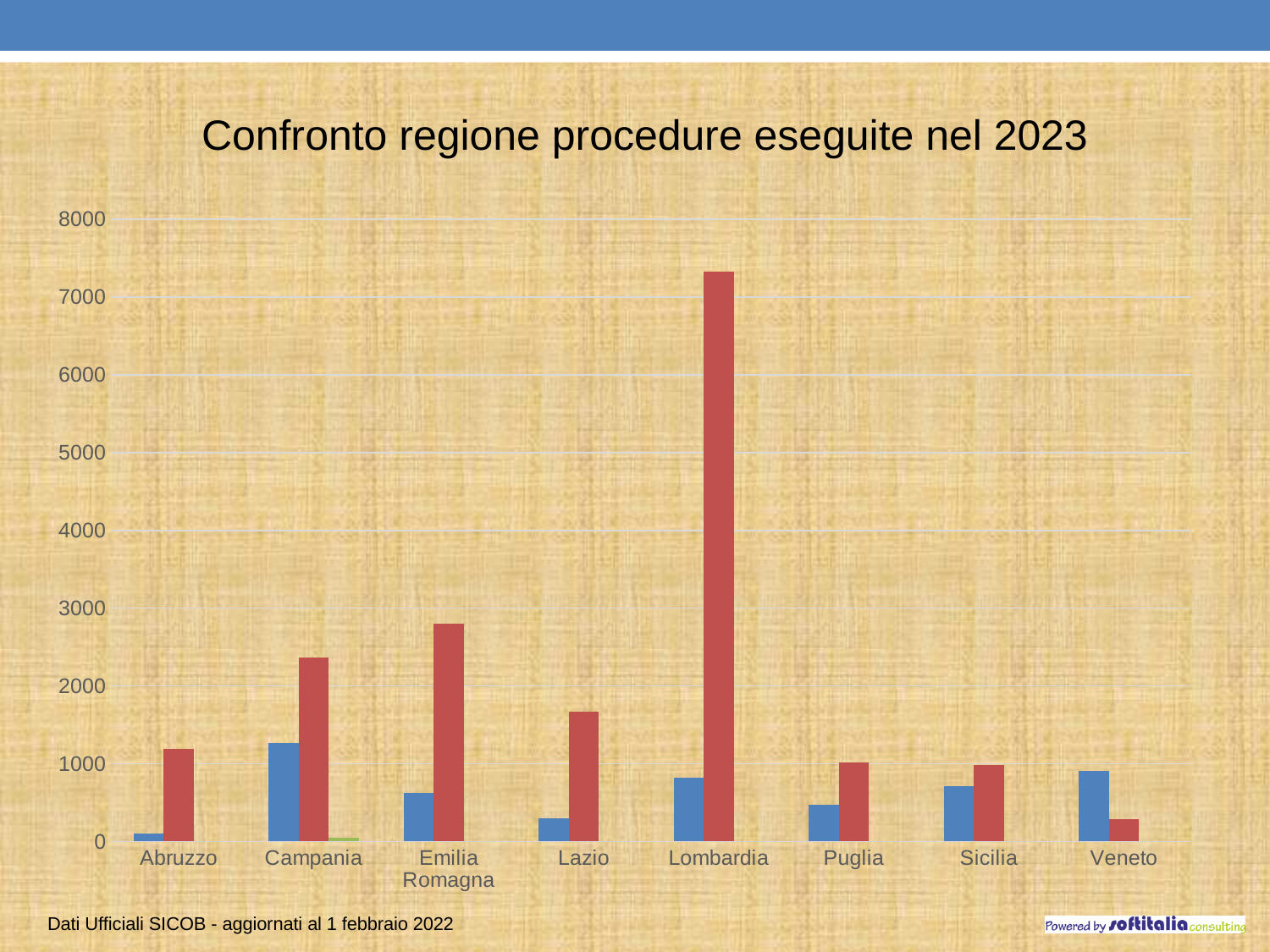
Which region has the shortest red bar? Veneto Is the value of the red bar for Emilia Romagna greater or less than 3000? less Is the value of the red bar for Lombardia greater or less than 7000? greater Which region has the larger red bar, Lazio or Campania? Campania Is the value of the blue bar for Campania greater or less than 1000? greater Which region has the shortest blue bar? Abruzzo Which region has the tallest red bar? Lombardia For Veneto, which bar is taller, the blue bar or the red bar? the blue bar What is the title of the chart? Confronto regione procedure eseguite nel 2023 Which region has the tallest blue bar? Campania What kind of chart is shown on the slide? bar chart How many regions are shown on the x axis of the chart? 8